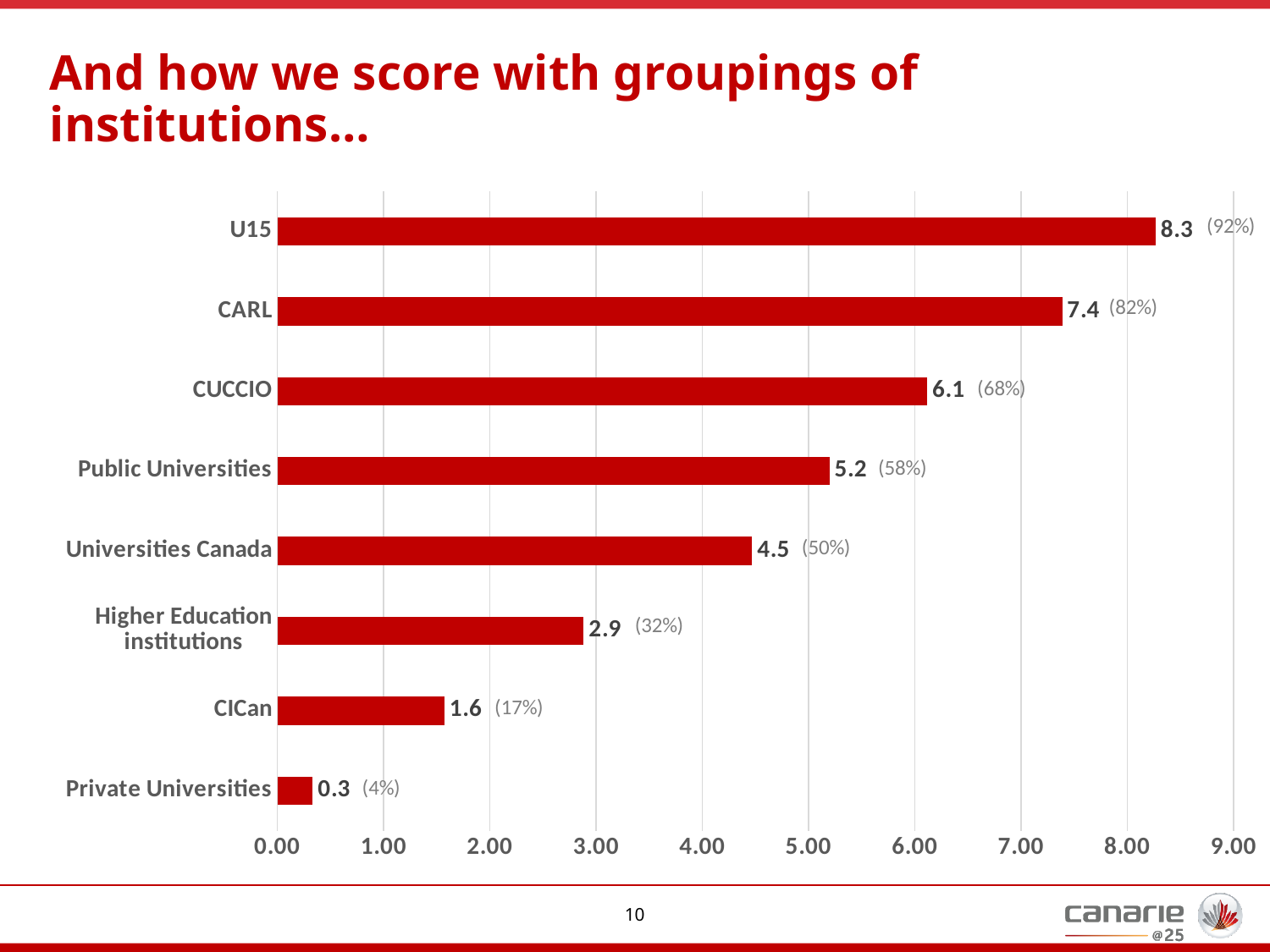
How many groupings of institutions are shown in the chart? 8 What is the score for CARL? 7.4 What is the difference between the scores for U15 and CARL? 0.9 Which grouping has the highest score? U15 What is the score for Universities Canada? 4.5 Which has a higher score, CUCCIO or Higher Education institutions? CUCCIO What percentage is shown in parentheses next to the CUCCIO bar? 68% What kind of chart is shown on the slide? Bar chart What is the maximum value shown on the horizontal axis? 9.00 Is the score for Public Universities greater or less than 5.00? greater Which grouping has the lowest score? Private Universities What is the difference between the scores for Public Universities and CICan? 3.6